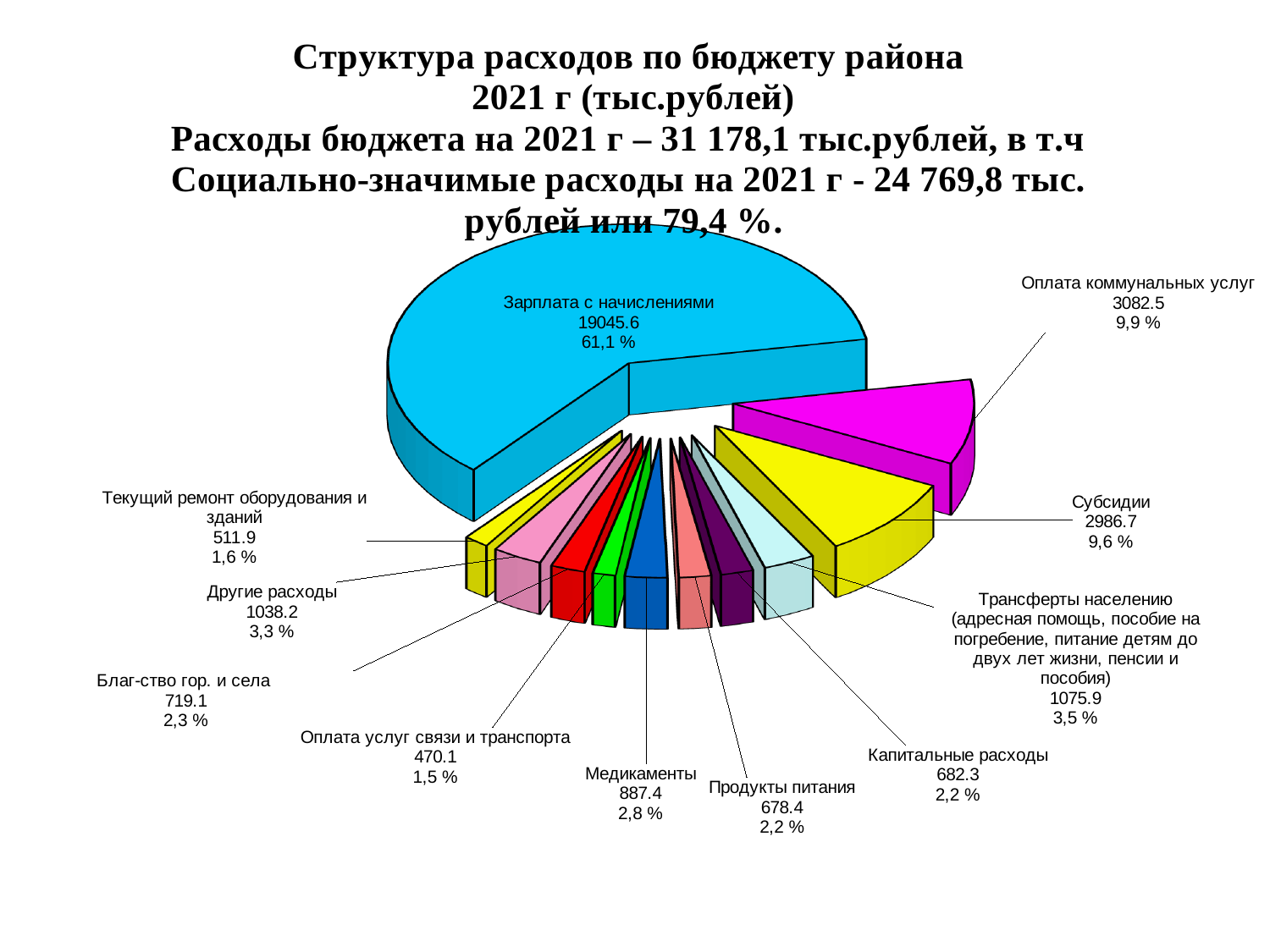
What is the value for Оплата коммунальных услуг? 3082.5 What is the value for Медикаменты? 887.4 Which category has the largest slice of the pie? Зарплата с начислениями What share of the pie does Другие расходы represent? 3,3 % How many slices does the pie chart have? 11 Which category has the smallest slice of the pie? Оплата услуг связи и транспорта What is the total budget expenditure for 2021 stated in the chart title? 31 178,1 тыс.рублей What kind of chart is shown on the slide? pie chart Which is larger, the value for Благ-ство гор. и села or the value for Капитальные расходы? Благ-ство гор. и села What share of the pie does Субсидии represent? 9,6 % What is the difference between the values for Оплата коммунальных услуг and Субсидии? 95.8 What is the value for Зарплата с начислениями? 19045.6